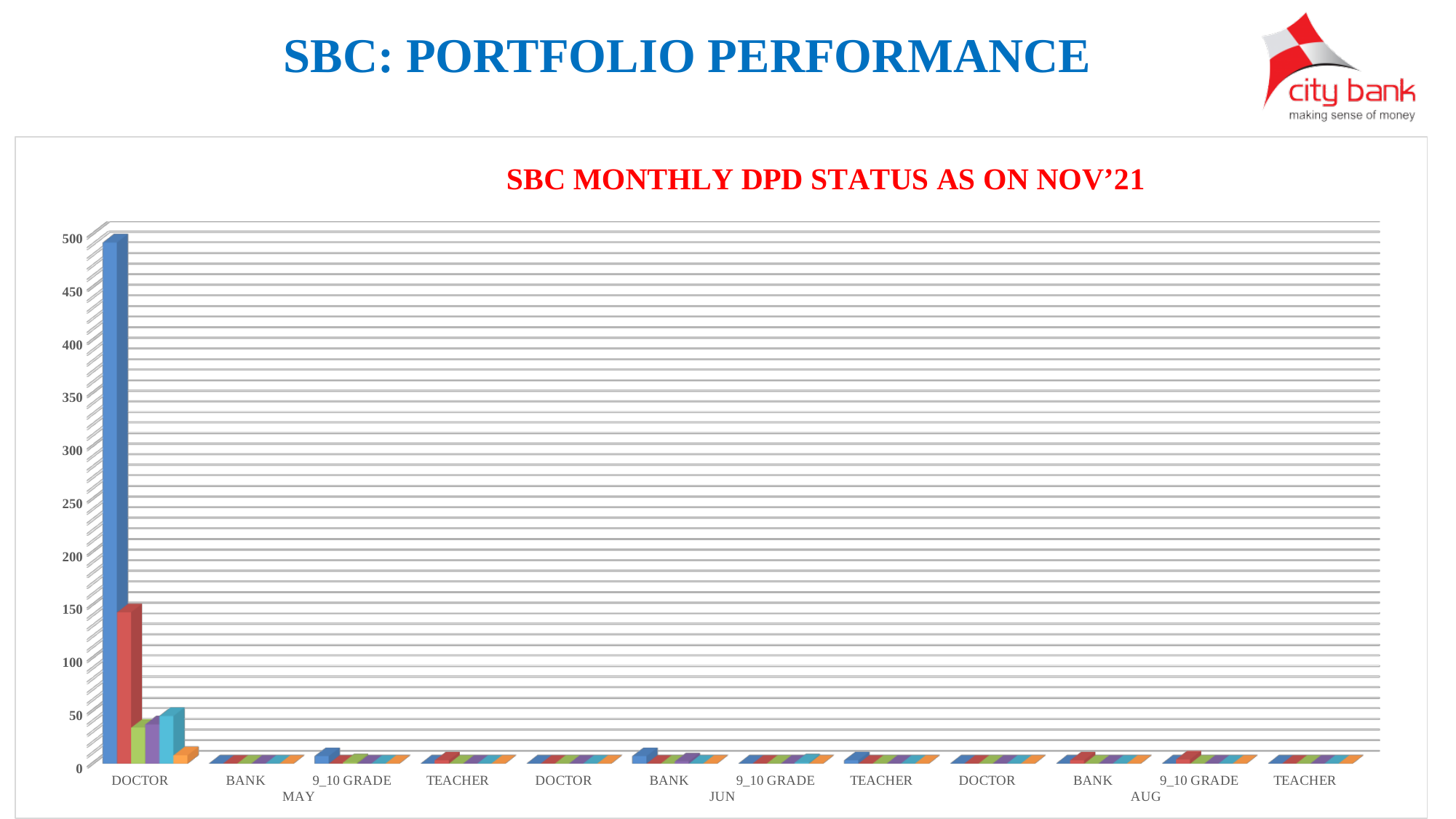
What is the title of the chart? SBC MONTHLY DPD STATUS AS ON NOV'21 Is the tallest bar for DOCTOR in MAY greater or less than 450? greater How many category labels are shown along the x axis of the chart? 12 Is the tallest bar for BANK in JUN greater or less than 50? less Which is larger: the tallest bar for DOCTOR in MAY or the tallest bar for DOCTOR in JUN? DOCTOR in MAY Is the tallest bar for TEACHER in AUG greater or less than 50? less Which month group contains the highest bar in the chart? MAY What is the highest value shown on the vertical axis? 500 Which category has the tallest bar in the chart? DOCTOR (MAY) What kind of chart is shown on the slide? bar chart How many month groups (MAY, JUN, AUG) are shown on the x axis? 3